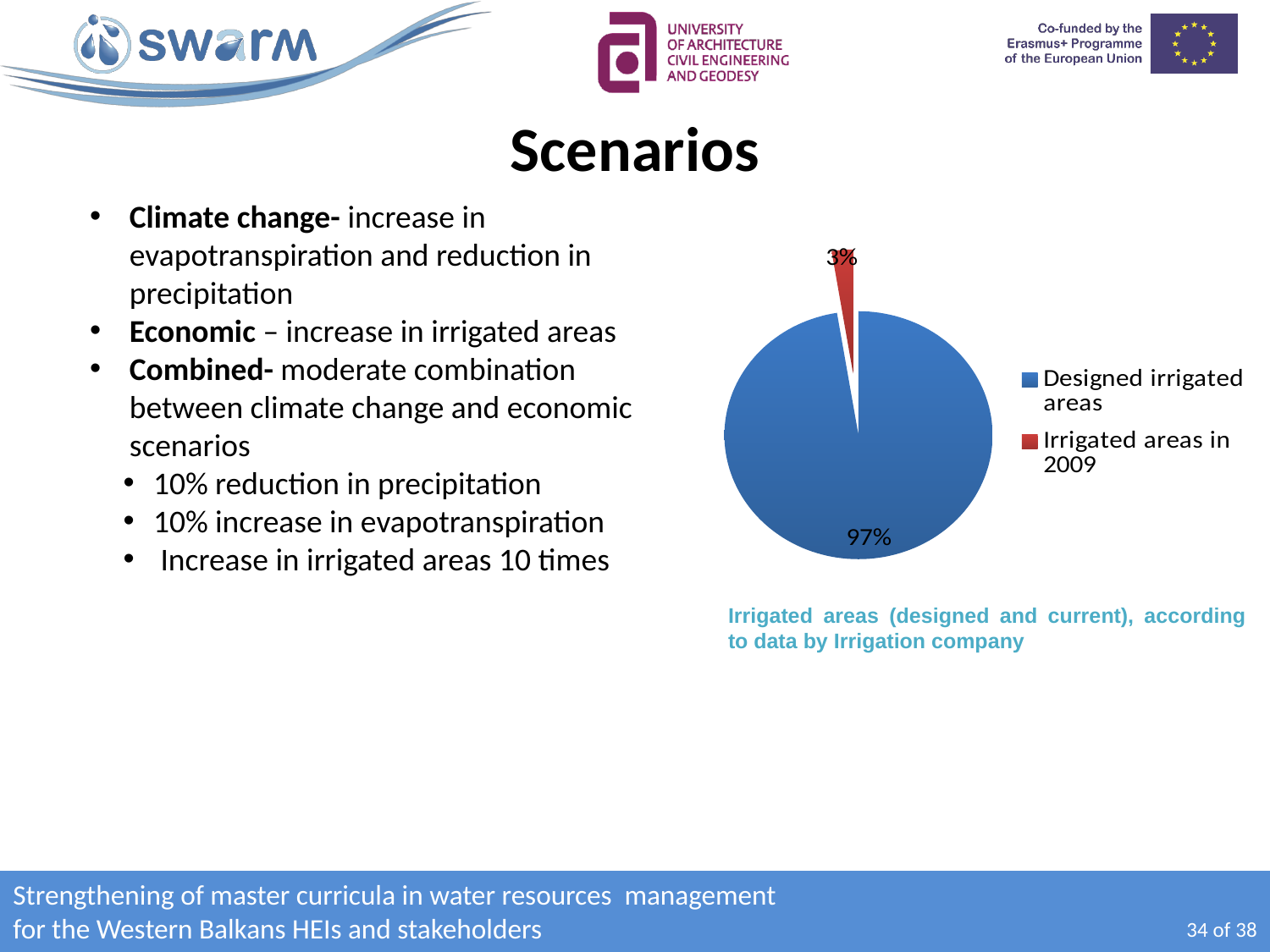
What is the difference in percentage points between the Designed irrigated areas slice and the Irrigated areas in 2009 slice? 94 Which slice of the pie is the smallest? Irrigated areas in 2009 Which is larger: the share for Designed irrigated areas or the share for Irrigated areas in 2009? Designed irrigated areas What share of the pie is labelled for Designed irrigated areas? 97% What share of the pie is labelled for Irrigated areas in 2009? 3% What colour is the slice for Irrigated areas in 2009? red What colour is the slice for Designed irrigated areas? blue Which slice of the pie is the largest? Designed irrigated areas How many slices does the pie chart have? 2 What kind of chart is shown on the slide? pie chart How many entries does the legend list? 2